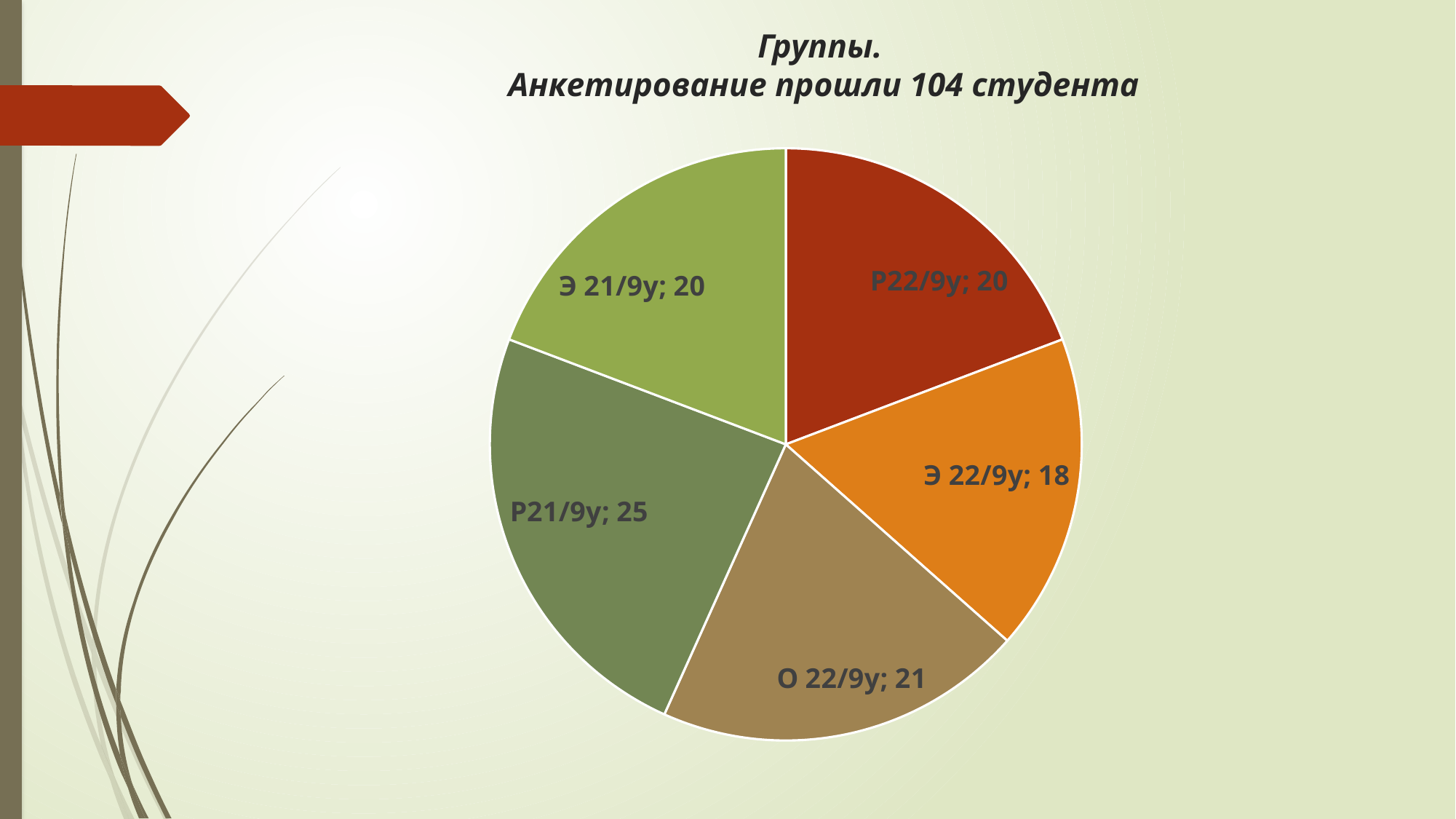
Which group has a larger value, О 22/9у or Э 22/9у? О 22/9у What is the value shown for group Э 22/9у? 18 What is the difference between the values for Р21/9у and Э 22/9у? 7 What colour is the slice for group Р22/9у? Dark red Which group has the largest slice in the pie chart? Р21/9у What is the value shown for group Р22/9у? 20 Which group has the smallest slice in the pie chart? Э 22/9у What kind of chart is shown on the slide? Pie chart How many students are in group Р21/9у according to the pie chart? 25 How many slices does the pie chart have? 5 What is the value shown for group О 22/9у? 21 According to the chart title, how many students took part in the survey? 104